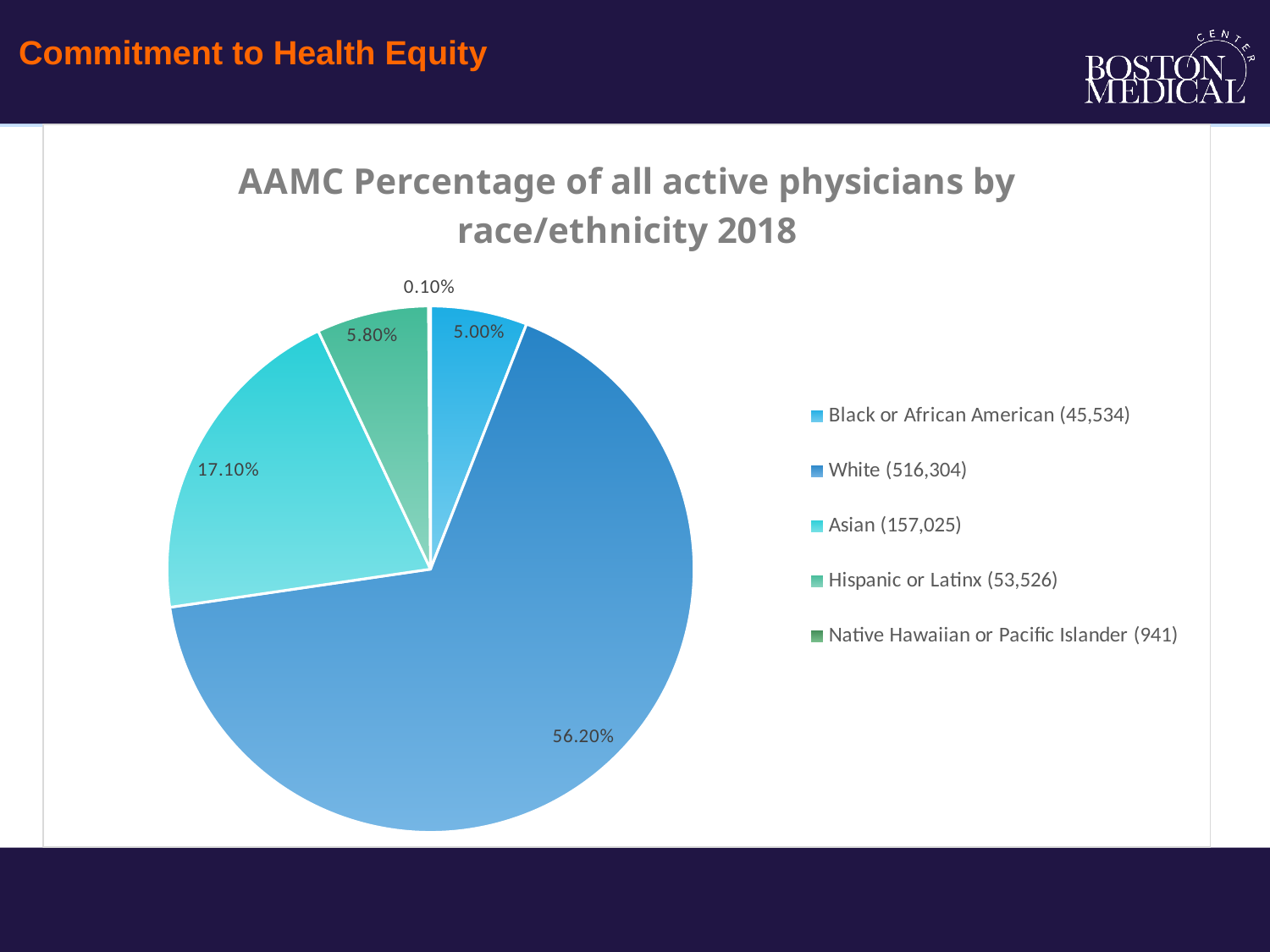
What percentage of the pie is the White slice? 56.20% What percentage of the pie is the Hispanic or Latinx slice? 5.80% Which slice is larger, Hispanic or Latinx or Black or African American? Hispanic or Latinx What percentage of the pie is the Native Hawaiian or Pacific Islander slice? 0.10% How many categories does the pie chart show? 5 What is the title of the chart? AAMC Percentage of all active physicians by race/ethnicity 2018 Which category has the largest slice of the pie? White What kind of chart is shown on the slide? Pie chart What is the difference in percentage points between the White slice and the Asian slice? 39.10% Which category has the smallest slice of the pie? Native Hawaiian or Pacific Islander